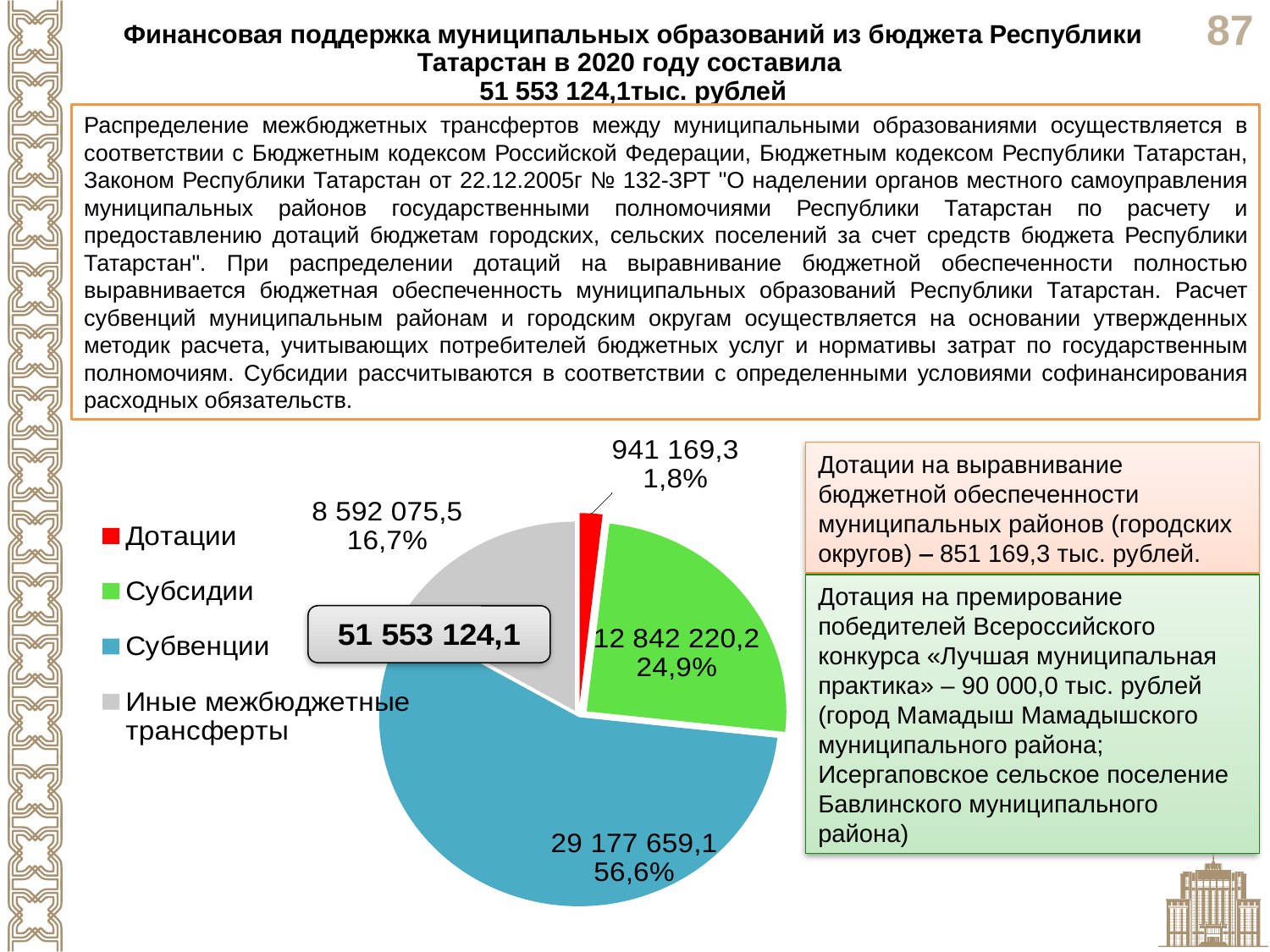
Which is larger in the pie chart, Субсидии or Иные межбюджетные трансферты? Субсидии What is the value shown for Дотации in the pie chart? 941 169,3 What percentage share does Субвенции have in the pie chart? 56,6% What percentage share does Иные межбюджетные трансферты have in the pie chart? 16,7% How many slices does the pie chart have? 4 What colour is the Субвенции slice in the pie chart? blue Which category has the largest slice in the pie chart? Субвенции What is the value shown for Субсидии in the pie chart? 12 842 220,2 What type of chart is shown on the slide? pie chart What is the value shown for Субвенции in the pie chart? 29 177 659,1 Which category has the smallest slice in the pie chart? Дотации How many entries does the legend of the pie chart list? 4